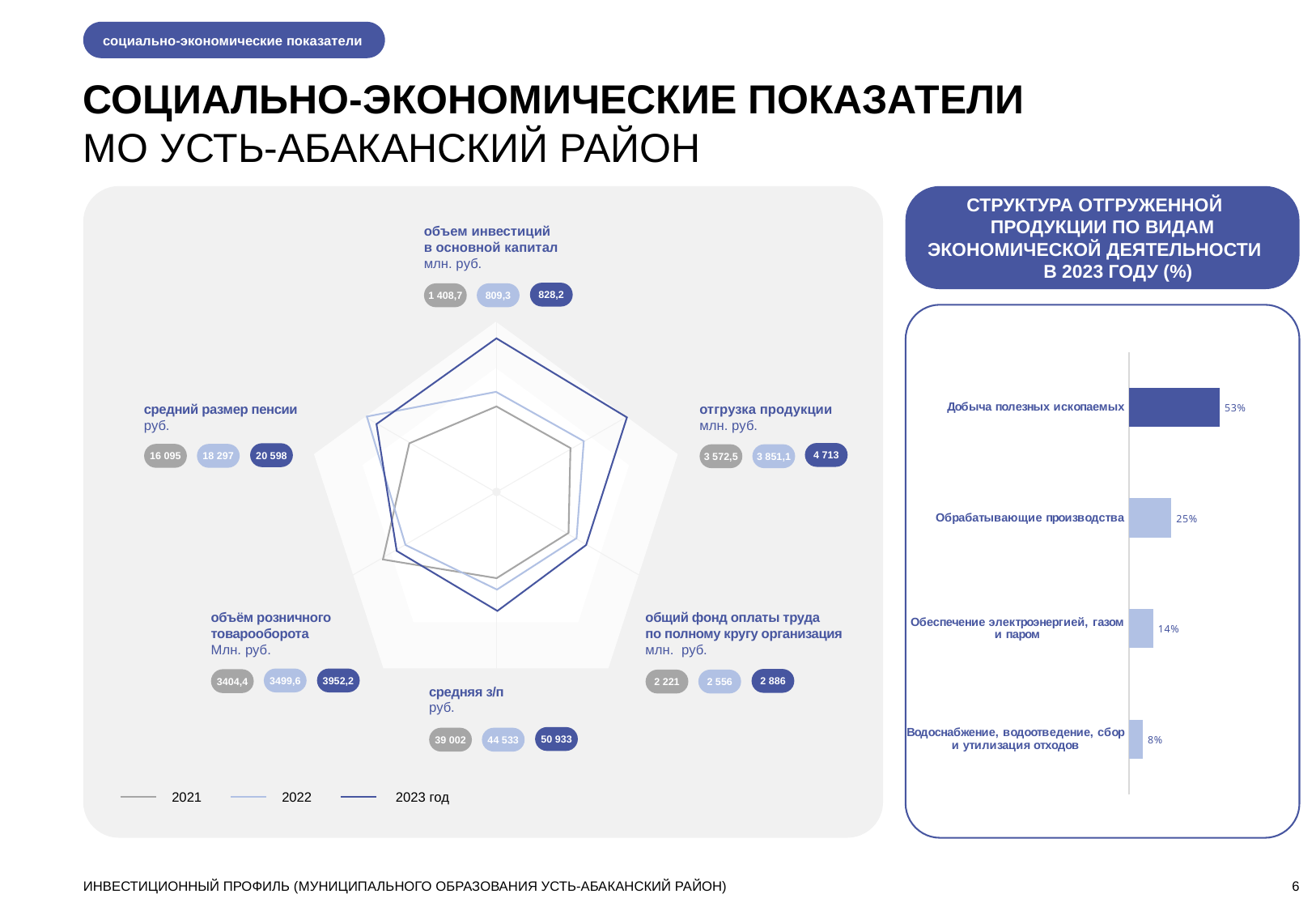
In the radar chart on the left, which is larger for отгрузка продукции: 2022 or 2023? 2023 In the radar chart on the left, what is the value of объем инвестиций в основной капитал for 2021? 1 408,7 In the bar chart on the right, which category has the highest value? Добыча полезных ископаемых In the radar chart on the left, how many indicators (axes) are shown? 6 In the radar chart on the left, what is the difference between the 2023 and 2021 values of средний размер пенсии? 4 503 In the bar chart on the right, how many categories are shown? 4 In the radar chart on the left, what is the value of средняя з/п for 2023? 50 933 In the bar chart on the right, which category has the lowest value? Водоснабжение, водоотведение, сбор и утилизация отходов In the bar chart on the right, what kind of chart is it? Bar chart In the bar chart on the right, what is the difference between Добыча полезных ископаемых and Обрабатывающие производства? 28 percentage points In the bar chart on the right, what is the value for Добыча полезных ископаемых? 53% In the radar chart on the left, how many series does the legend list? 3